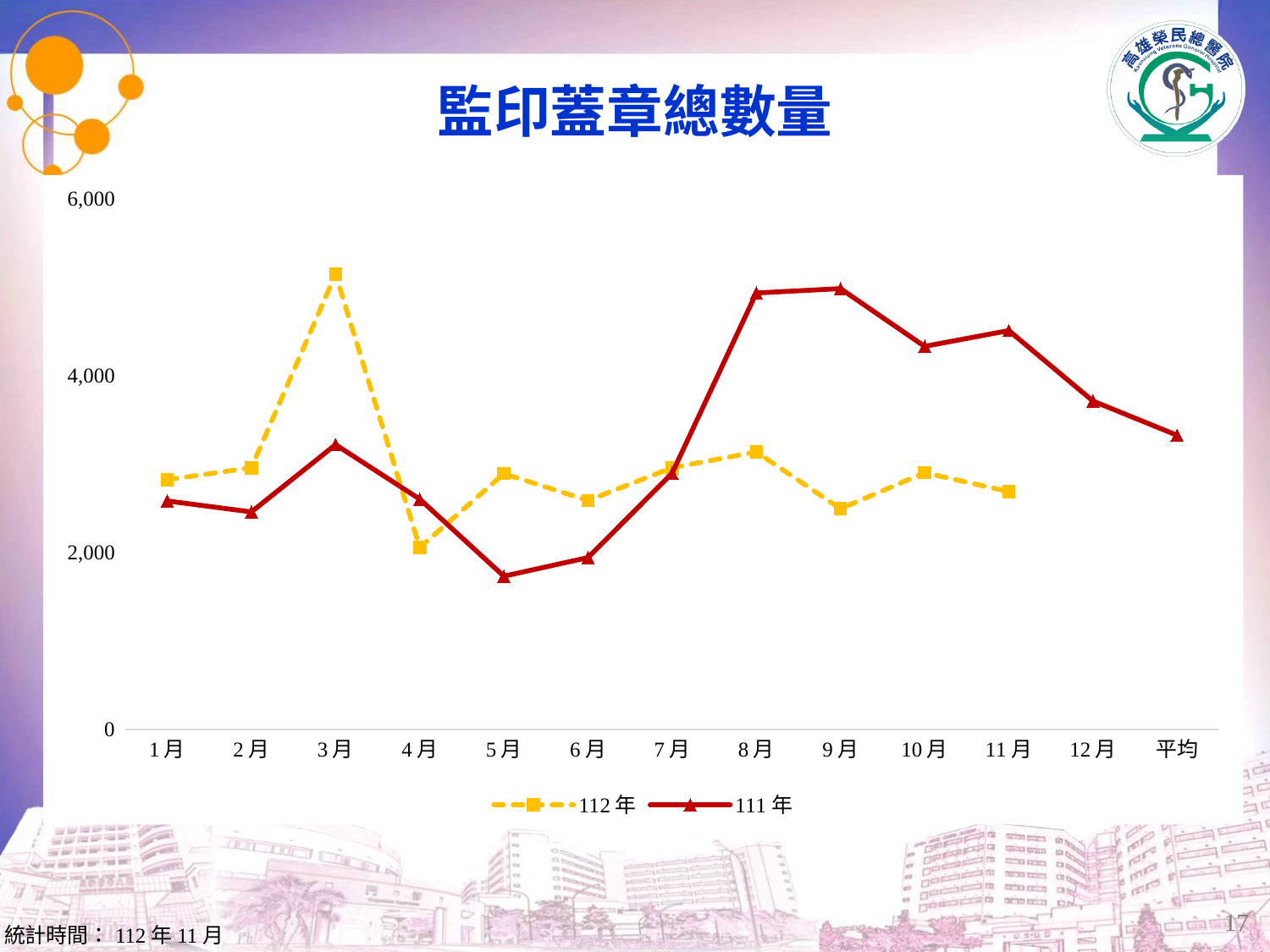
Which series is drawn with a dashed line? 112年 What is the title of the chart? 監印蓋章總數量 What kind of chart is shown on the slide? line chart In 9月, which series has the larger value, 112年 or 111年? 111年 In which month does the 111年 series reach its lowest value? 5月 How many series does the legend list? 2 How many categories are shown on the x axis? 13 Does the 111年 series rise or fall from 9月 to 12月? fall Is the value for 112年 in 3月 greater or less than 4,000? greater Is the value for 111年 in 5月 greater or less than 2,000? less In which month does the 112年 series reach its highest value? 3月 In which month does the 112年 series reach its lowest value? 4月